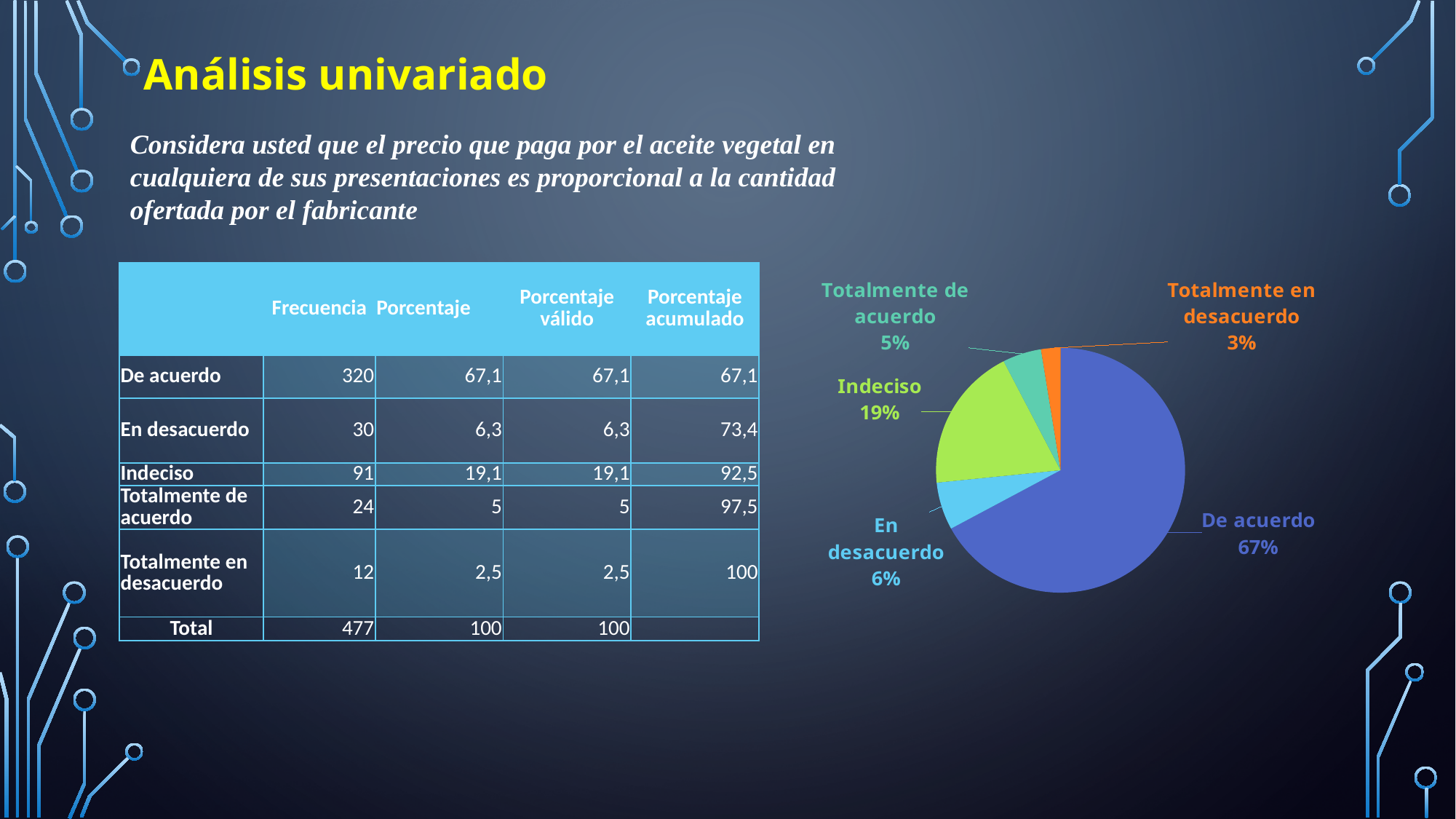
Which category has the largest slice in the pie chart? De acuerdo How many slices does the pie chart have? 5 What share of the pie chart does "En desacuerdo" represent? 6% What share of the pie chart does "Indeciso" represent? 19% In the pie chart, which is larger: "Indeciso" or "En desacuerdo"? Indeciso What colour is the "De acuerdo" slice in the pie chart? Blue What share of the pie chart does "Totalmente en desacuerdo" represent? 3% Which category has the smallest slice in the pie chart? Totalmente en desacuerdo What is the difference in percentage points between the "De acuerdo" and "Indeciso" slices in the pie chart? 48% What kind of chart is shown on the slide? Pie chart